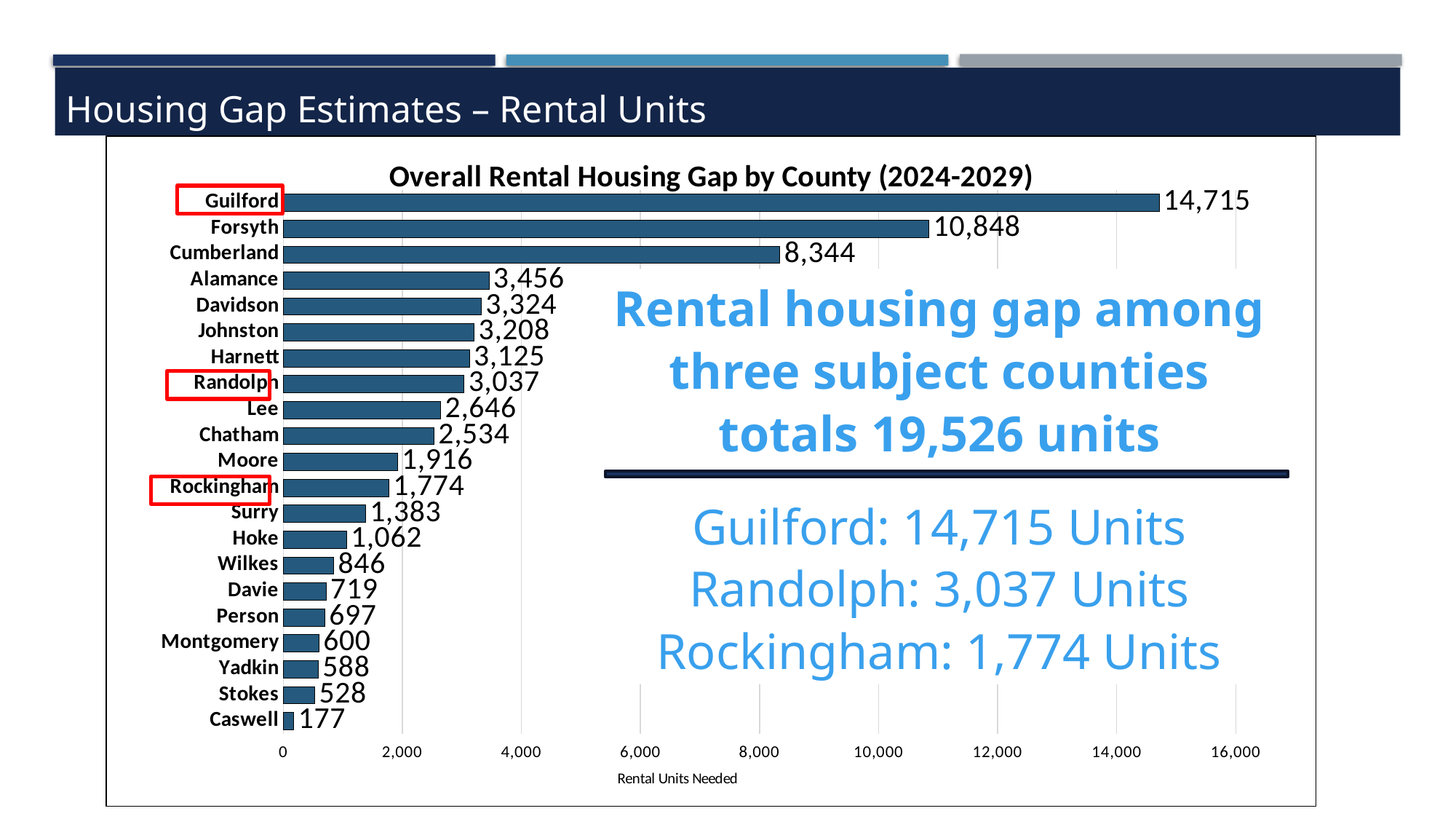
How many counties are shown in the chart? 21 What is the difference between the values for Randolph and Rockingham? 1,263 Which county has the lowest rental housing gap? Caswell What is the rental housing gap value for Yadkin? 588 What is the difference between the values for Guilford and Forsyth? 3,867 Is the value for Forsyth greater or less than 10,000? greater What is the rental housing gap value for Moore? 1,916 What is the title of the chart? Overall Rental Housing Gap by County (2024-2029) Which has a larger rental housing gap, Alamance or Johnston? Alamance Which county has the highest rental housing gap? Guilford What kind of chart is shown on the slide? Bar chart What is the rental housing gap value for Cumberland? 8,344